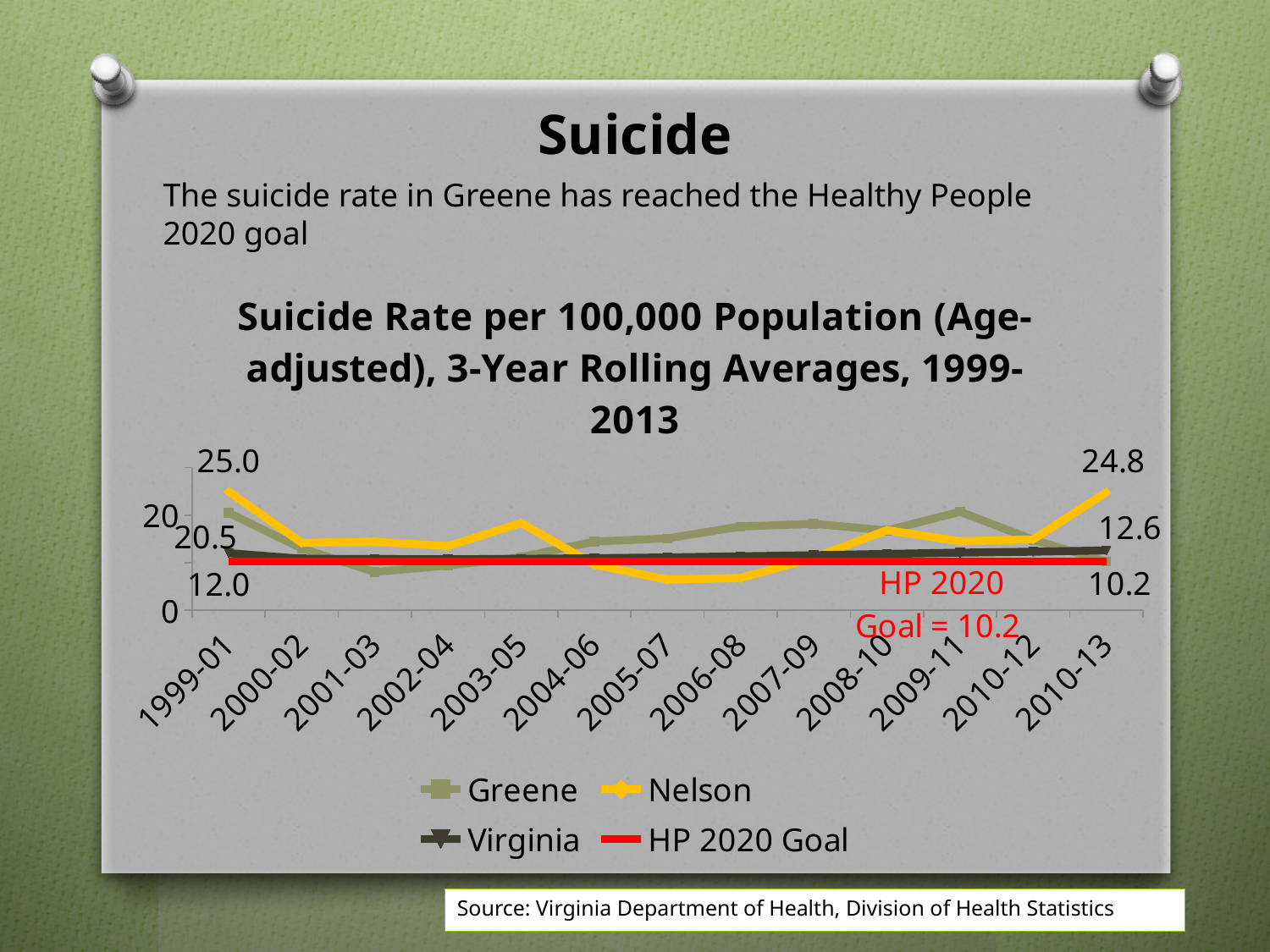
What type of chart is shown on the slide? line chart What colour is the HP 2020 Goal line in the legend? red What is the suicide rate for Greene in 1999-01? 20.5 What is the difference between the Nelson and Greene values in 1999-01? 4.5 What is the value of the HP 2020 Goal line? 10.2 What is the suicide rate for Nelson in 2010-13? 24.8 How many series does the legend list? 4 What is the suicide rate for Virginia in 1999-01? 12.0 How many time periods are shown on the x axis? 13 Which series has the higher value in 1999-01, Nelson or Greene? Nelson What is the suicide rate for Nelson in 1999-01? 25.0 Which series has the lowest value in 1999-01? HP 2020 Goal